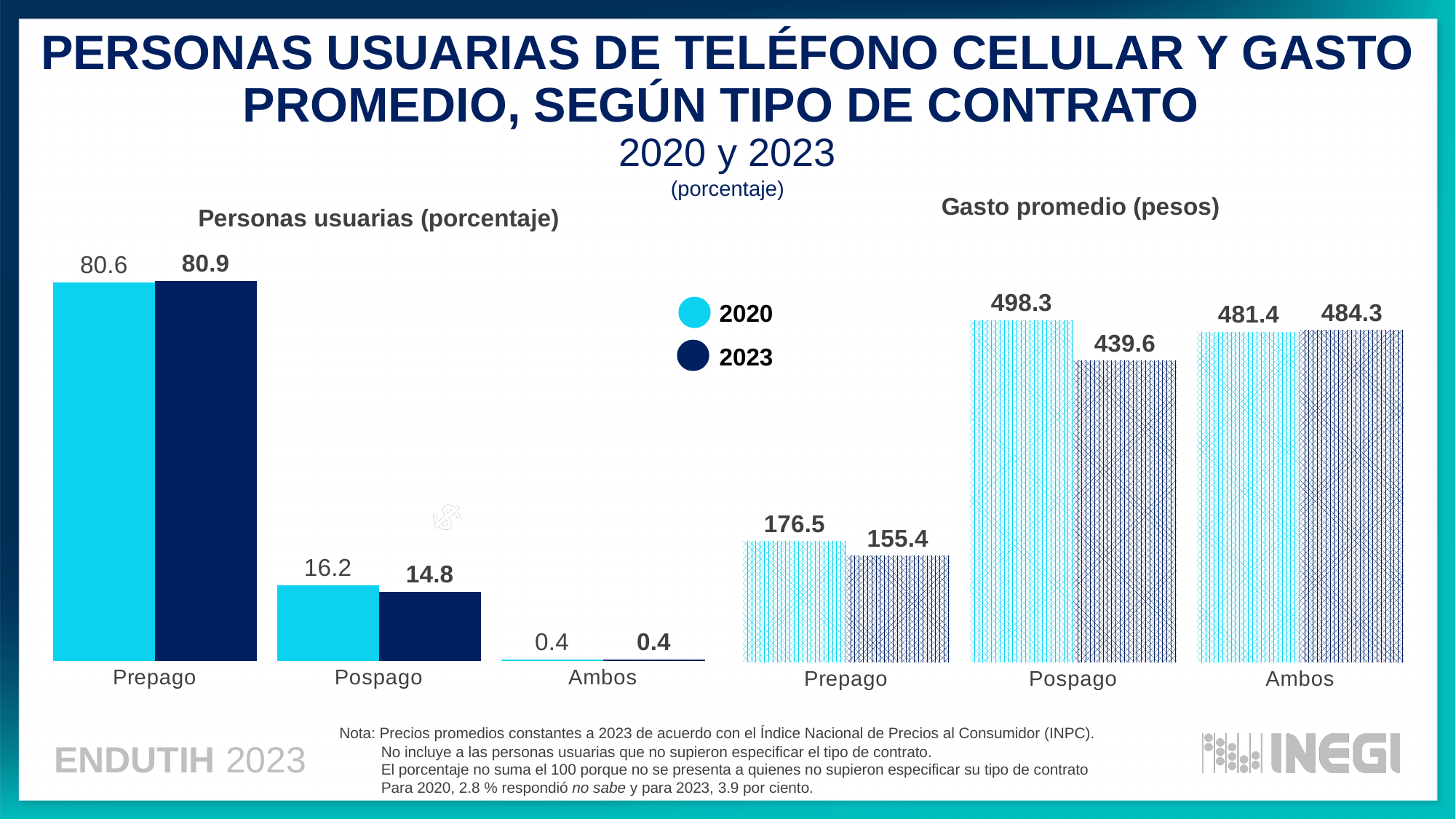
In the 'Gasto promedio (pesos)' chart, what is the difference between the 2020 and 2023 values for Prepago? 21.1 In the 'Personas usuarias (porcentaje)' chart, what is the value for Prepago in 2023? 80.9 How many categories are shown in the 'Gasto promedio (pesos)' chart? 3 In the 'Gasto promedio (pesos)' chart, which category has the highest value for 2020? Pospago What kind of chart is the 'Personas usuarias (porcentaje)' chart? Bar chart In the 'Gasto promedio (pesos)' chart, what is the value for Ambos in 2020? 481.4 How many series does the legend list? 2 In the 'Personas usuarias (porcentaje)' chart, what is the difference between the 2020 and 2023 values for Pospago? 1.4 In the 'Personas usuarias (porcentaje)' chart, what is the value for Pospago in 2020? 16.2 In the 'Gasto promedio (pesos)' chart, which is larger for Pospago: the 2020 value or the 2023 value? 2020 In the 'Personas usuarias (porcentaje)' chart, which category has the lowest value for 2023? Ambos In the 'Gasto promedio (pesos)' chart, what is the value for Pospago in 2023? 439.6